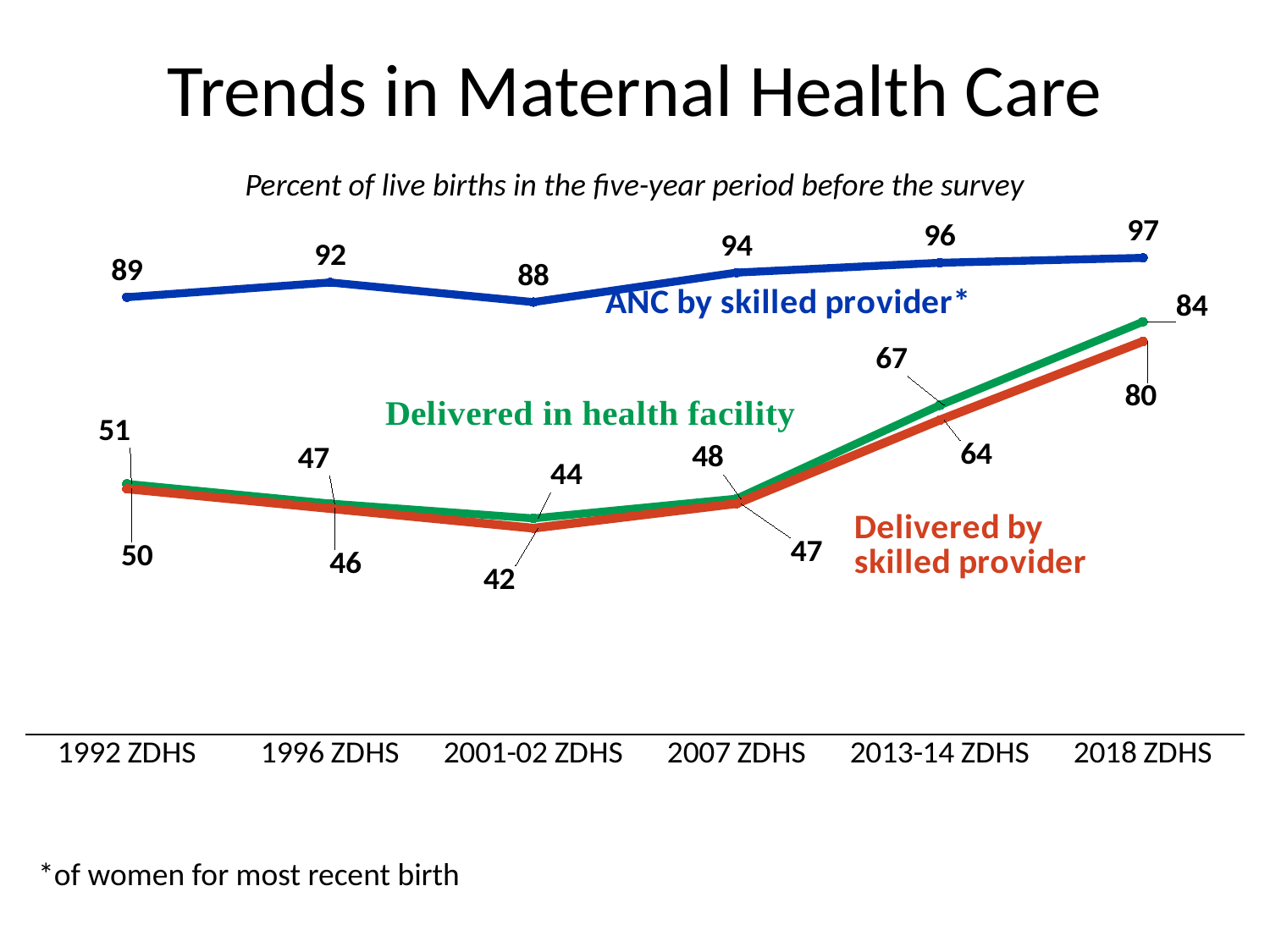
What is the value for Delivered in health facility in the 2013-14 ZDHS? 67 By how much did ANC by skilled provider increase from the 1992 ZDHS to the 2018 ZDHS? 8 What is the difference between Delivered in health facility and Delivered by skilled provider in the 2018 ZDHS? 4 What is the value for ANC by skilled provider in the 2018 ZDHS? 97 Which is larger in the 2007 ZDHS: Delivered in health facility or Delivered by skilled provider? Delivered in health facility How many surveys are shown on the x axis? 6 What type of chart is shown on the slide? line chart What is the value for Delivered by skilled provider in the 2001-02 ZDHS? 42 In which survey is the value for Delivered by skilled provider highest? 2018 ZDHS Does the value for Delivered by skilled provider rise or fall from the 2007 ZDHS to the 2018 ZDHS? rise In which survey is the value for ANC by skilled provider lowest? 2001-02 ZDHS How many series are plotted on the chart? 3